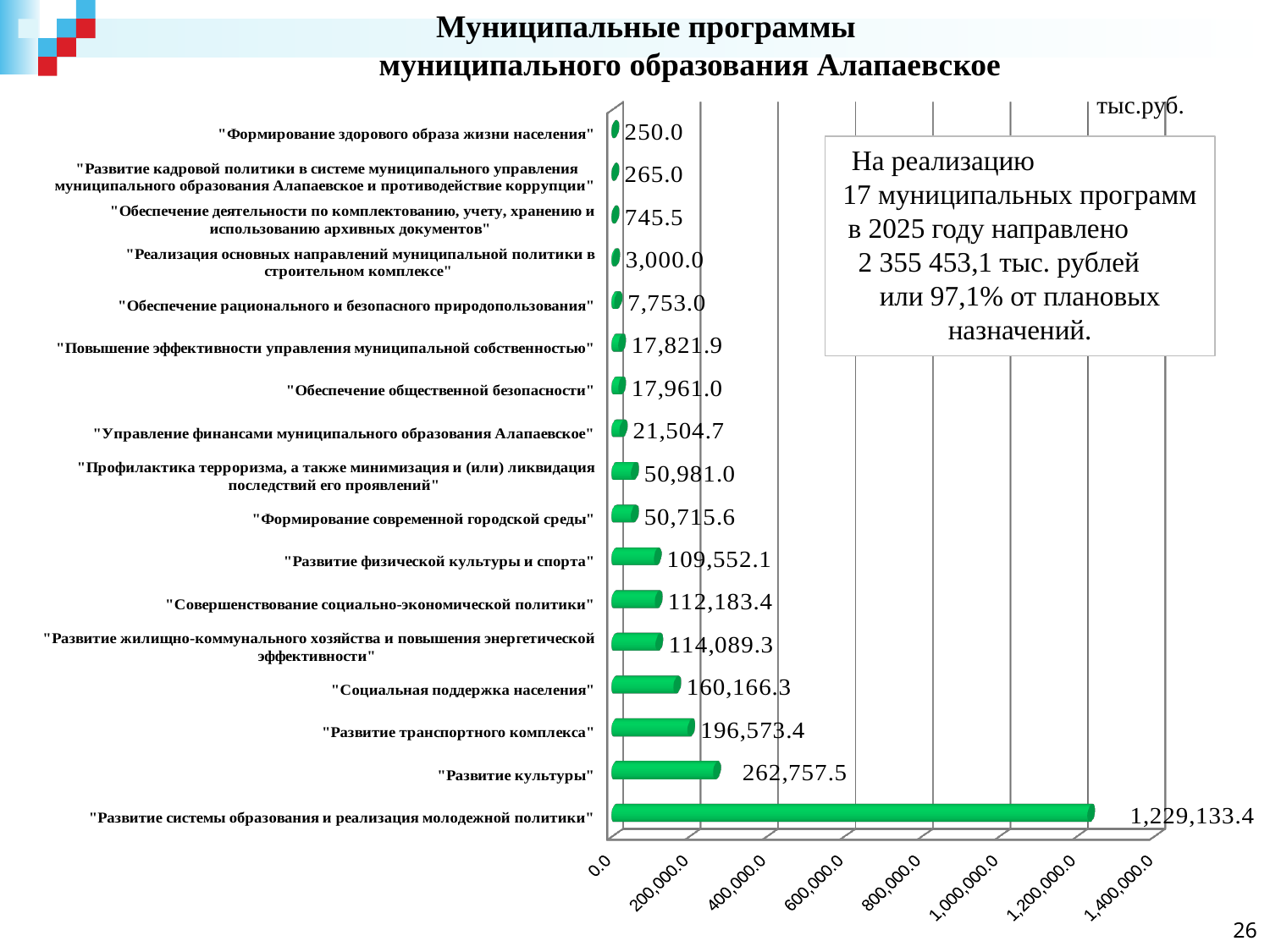
Which program has the highest value? "Развитие системы образования и реализация молодежной политики" Which program has the lowest value? "Формирование здорового образа жизни населения" Which is larger: the value for "Профилактика терроризма, а также минимизация и (или) ликвидация последствий его проявлений" or for "Формирование современной городской среды"? "Профилактика терроризма, а также минимизация и (или) ликвидация последствий его проявлений" What is the difference between the values for "Развитие культуры" and "Развитие транспортного комплекса"? 66,184.1 How many programs are shown in the chart? 17 What is the value for "Развитие культуры"? 262,757.5 In what units are the values on the chart given? тыс.руб. What kind of chart is shown on the slide? bar chart What is the value for "Обеспечение общественной безопасности"? 17,961.0 What is the difference between the values for "Социальная поддержка населения" and "Развитие жилищно-коммунального хозяйства и повышения энергетической эффективности"? 46,077.0 Is the value for "Развитие системы образования и реализация молодежной политики" greater or less than 1,200,000.0? greater What is the value for "Социальная поддержка населения"? 160,166.3